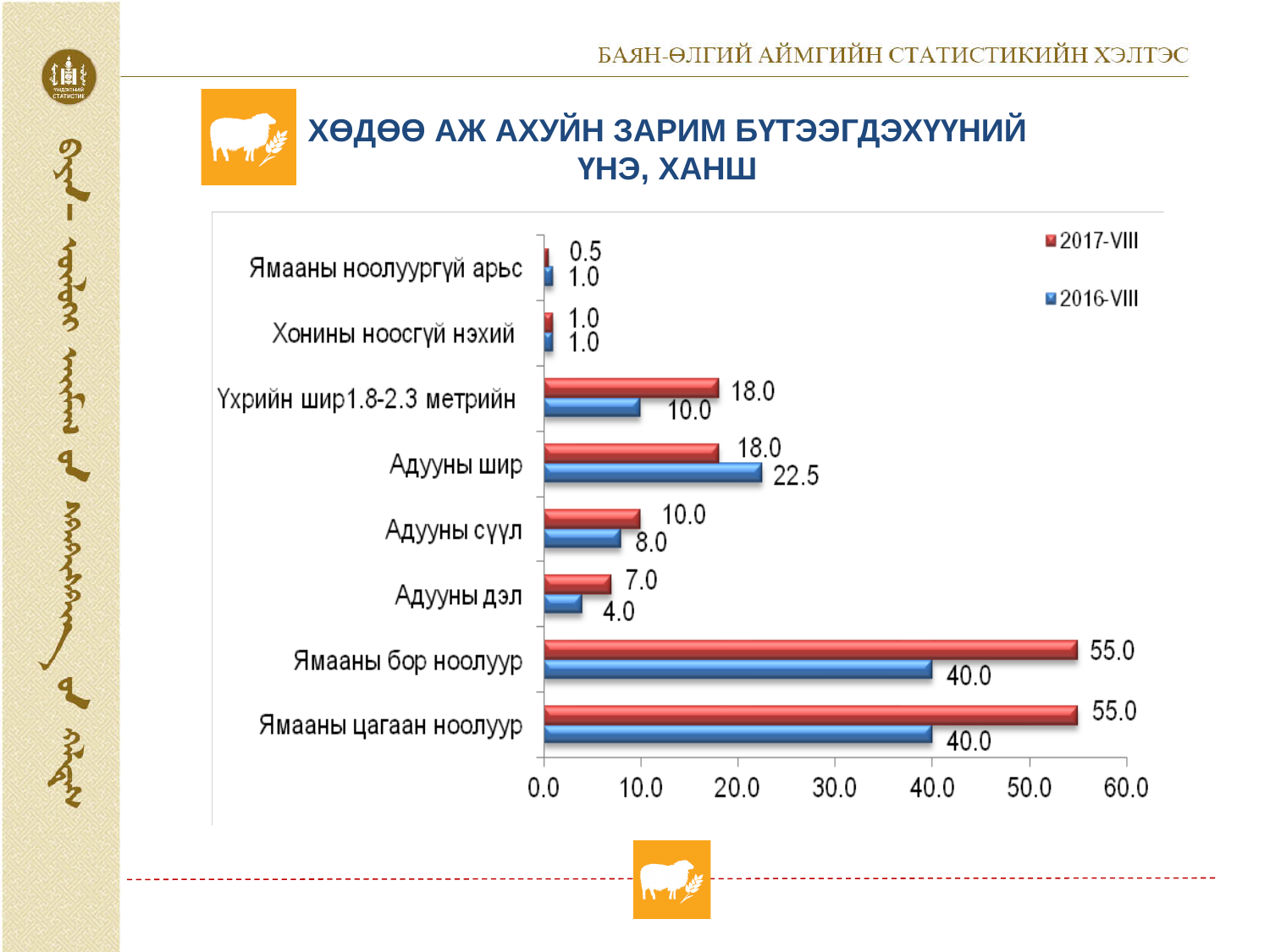
Which is larger for Үхрийн шир1.8-2.3 метрийн: the 2017-VIII value or the 2016-VIII value? 2017-VIII How many series does the legend list? 2 What type of chart is shown on the slide? Bar chart What is the 2016-VIII value for Адууны шир? 22.5 What is the 2016-VIII value for Адууны дэл? 4.0 Which colour represents the 2016-VIII series in the chart? Blue What is the difference between the 2016-VIII and 2017-VIII values for Адууны сүүл? 2.0 What is the difference between the 2017-VIII and 2016-VIII values for Ямааны бор ноолуур? 15.0 How many categories are plotted on the chart? 8 What is the 2017-VIII value for Адууны шир? 18.0 What is the 2017-VIII value for Ямааны ноолуургүй арьс? 0.5 Which category has the lowest 2017-VIII value? Ямааны ноолуургүй арьс